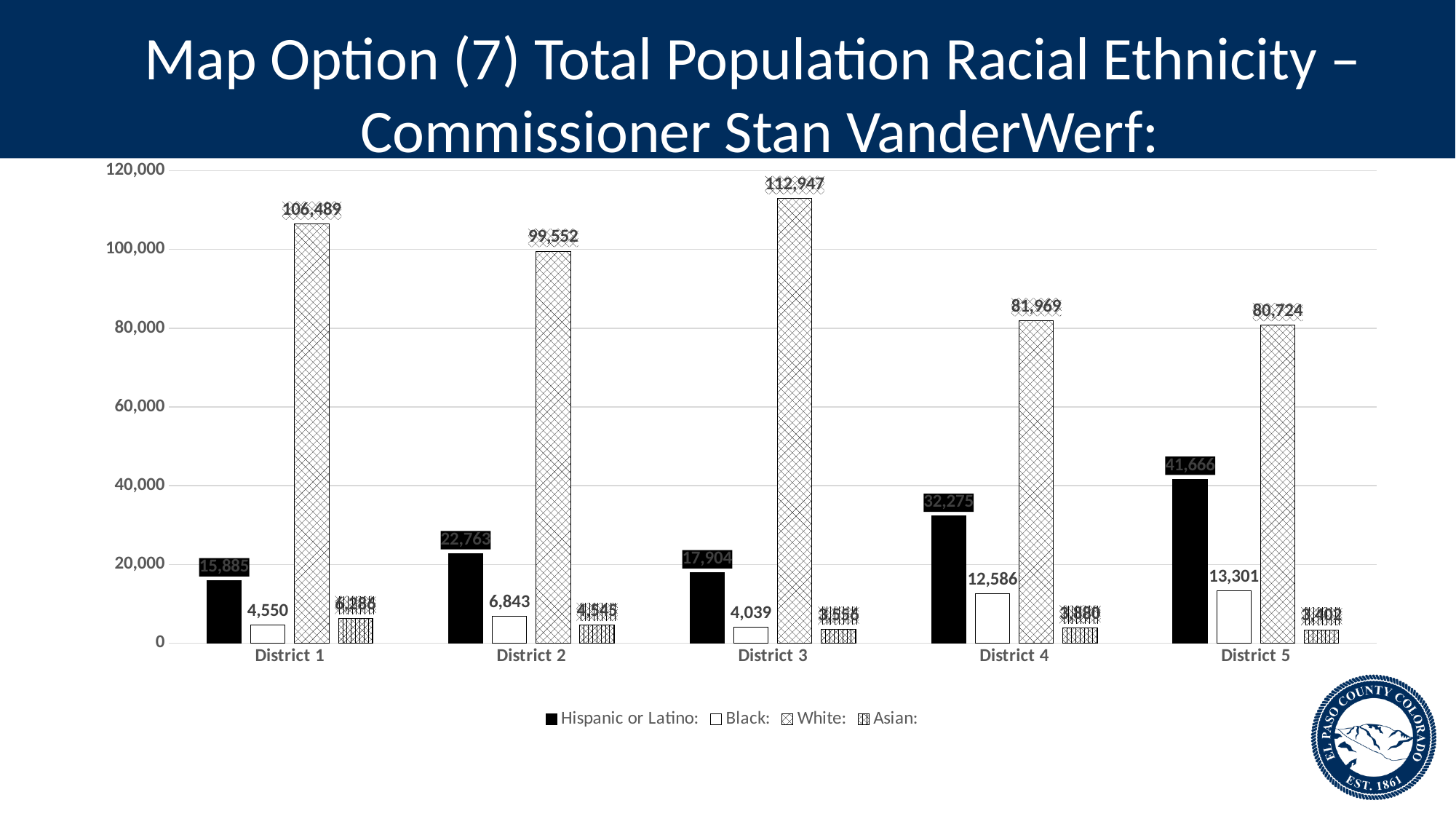
Which district has the highest White population? District 3 How many series does the legend list? 4 Does the Hispanic or Latino population rise or fall from District 3 to District 5? rise Which district has the lowest Black population? District 3 What is the difference between the White populations of District 1 and District 2? 6,937 Is the White population for District 4 greater or less than 80,000? greater What is the Black population for District 4? 12,586 How many districts are shown on the x axis? 5 What is the White population for District 3? 112,947 Which is larger, the Hispanic or Latino population of District 2 or of District 3? District 2 What is the Hispanic or Latino population for District 5? 41,666 What kind of chart is shown on the slide? bar chart